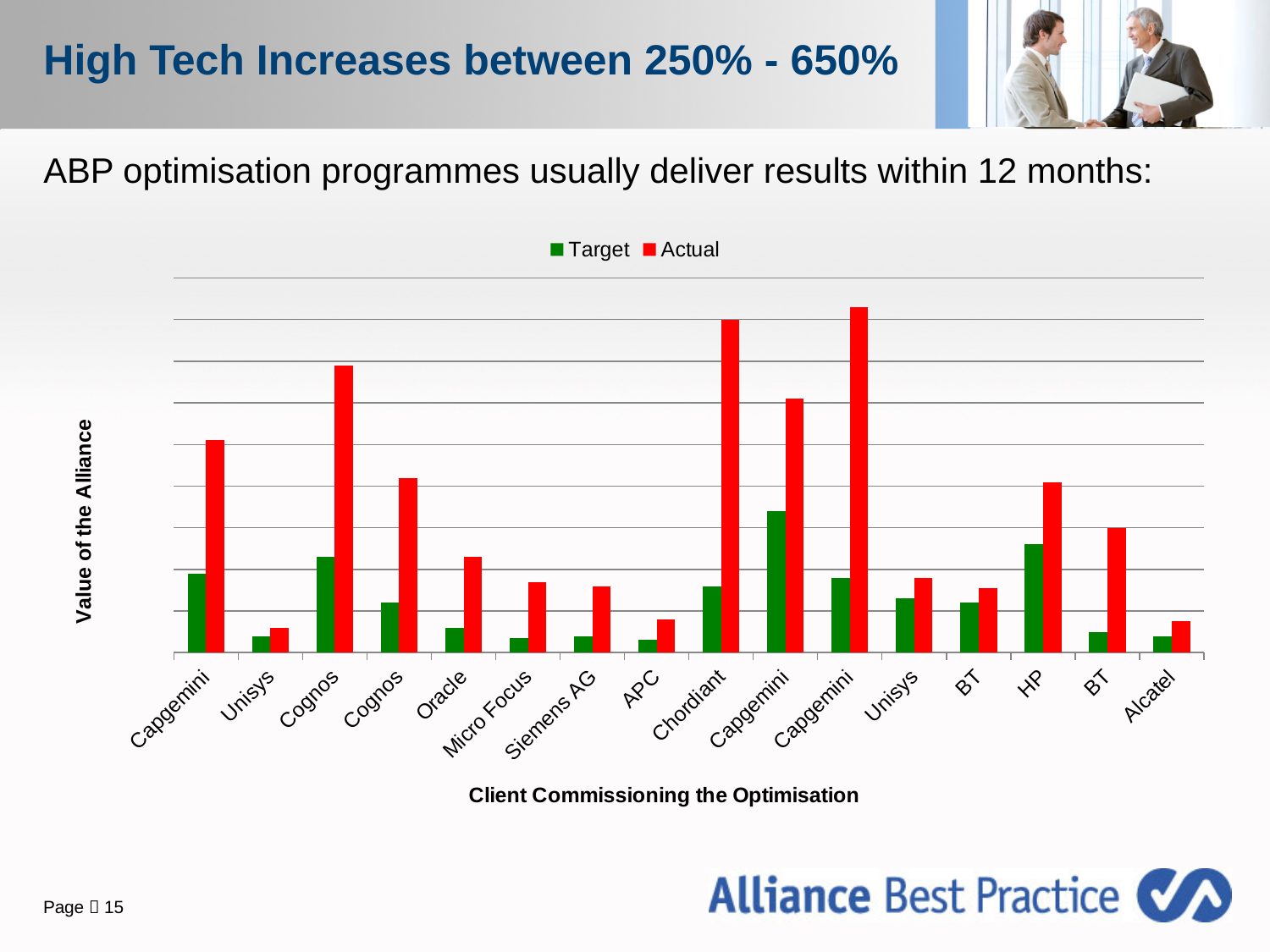
How many client categories are shown along the x axis? 16 Which is larger, the Actual value for Oracle or the Actual value for Alcatel? Oracle For Chordiant, which is larger, the Target bar or the Actual bar? Actual Which is larger, the Actual value for HP or the Actual value for Micro Focus? HP What is the label on the vertical axis? Value of the Alliance What kind of chart is shown on the slide? bar chart How many series does the legend list? 2 Which series is shown in red in the legend? Actual